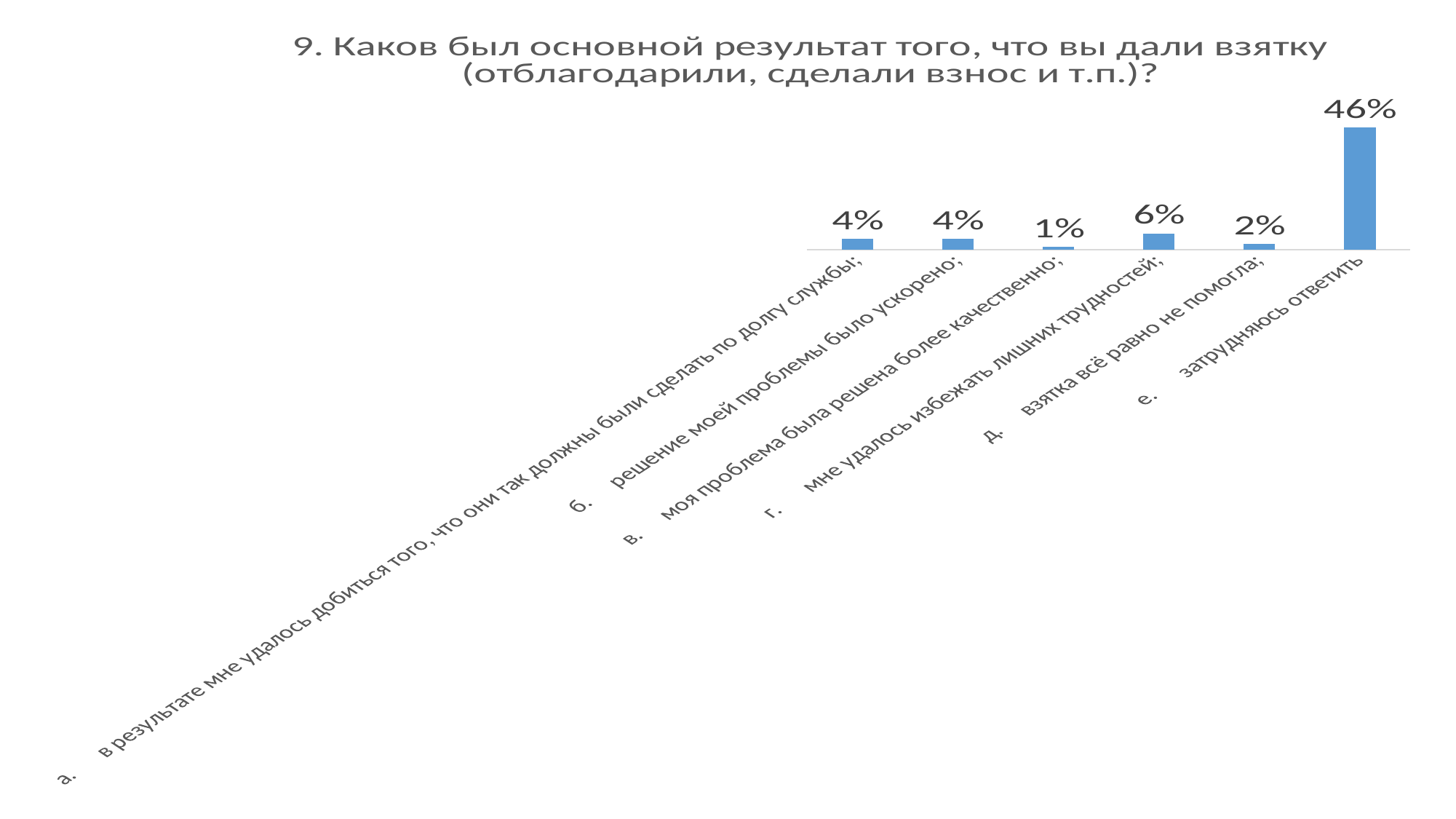
Which category has the lowest value? в. моя проблема была решена более качественно What value is shown for "г. мне удалось избежать лишних трудностей"? 6% What value is shown for "в. моя проблема была решена более качественно"? 1% What is the difference between the values for "б. решение моей проблемы было ускорено" and "в. моя проблема была решена более качественно"? 3% What value is shown for "д. взятка всё равно не помогла"? 2% Which is larger: the value for "г. мне удалось избежать лишних трудностей" or the value for "д. взятка всё равно не помогла"? г. мне удалось избежать лишних трудностей What type of chart is shown on the slide? Bar chart Which category has the highest value? затрудняюсь ответить What colour are the bars in the chart? Blue How many categories are shown in the chart? 6 What is the difference between the value for "затрудняюсь ответить" and the value for "г. мне удалось избежать лишних трудностей"? 40% What value is shown for the category "затрудняюсь ответить"? 46%